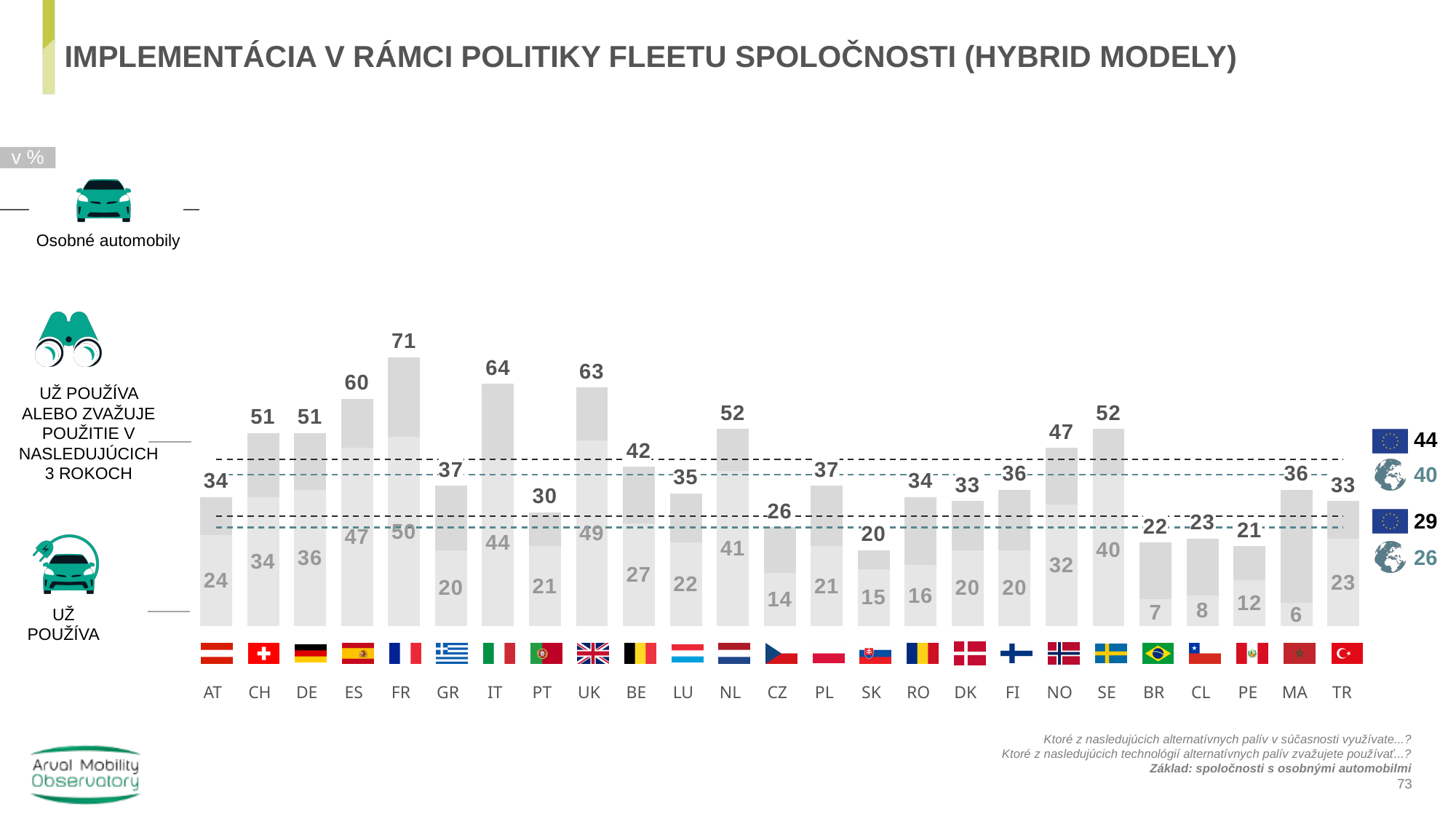
What is the difference between the 'už používa alebo zvažuje' value for IT and for UK? 1 Which country has the highest value for 'už používa alebo zvažuje použitie v nasledujúcich 3 rokoch'? FR What is the global reference value shown for 'už používa'? 26 How many countries are shown on the chart? 25 What kind of chart is shown on the slide? Bar chart Which has a higher 'už používa' value, SE or NO? SE What is the 'už používa' value for NL? 41 What is the value for FR for 'už používa alebo zvažuje použitie v nasledujúcich 3 rokoch'? 71 What is the difference between the 'už používa' values for ES and for BR? 40 What is the EU reference value shown for 'už používa alebo zvažuje použitie v nasledujúcich 3 rokoch'? 44 Which country has the lowest 'už používa' value? MA Which country has the lowest value for 'už používa alebo zvažuje použitie v nasledujúcich 3 rokoch'? SK